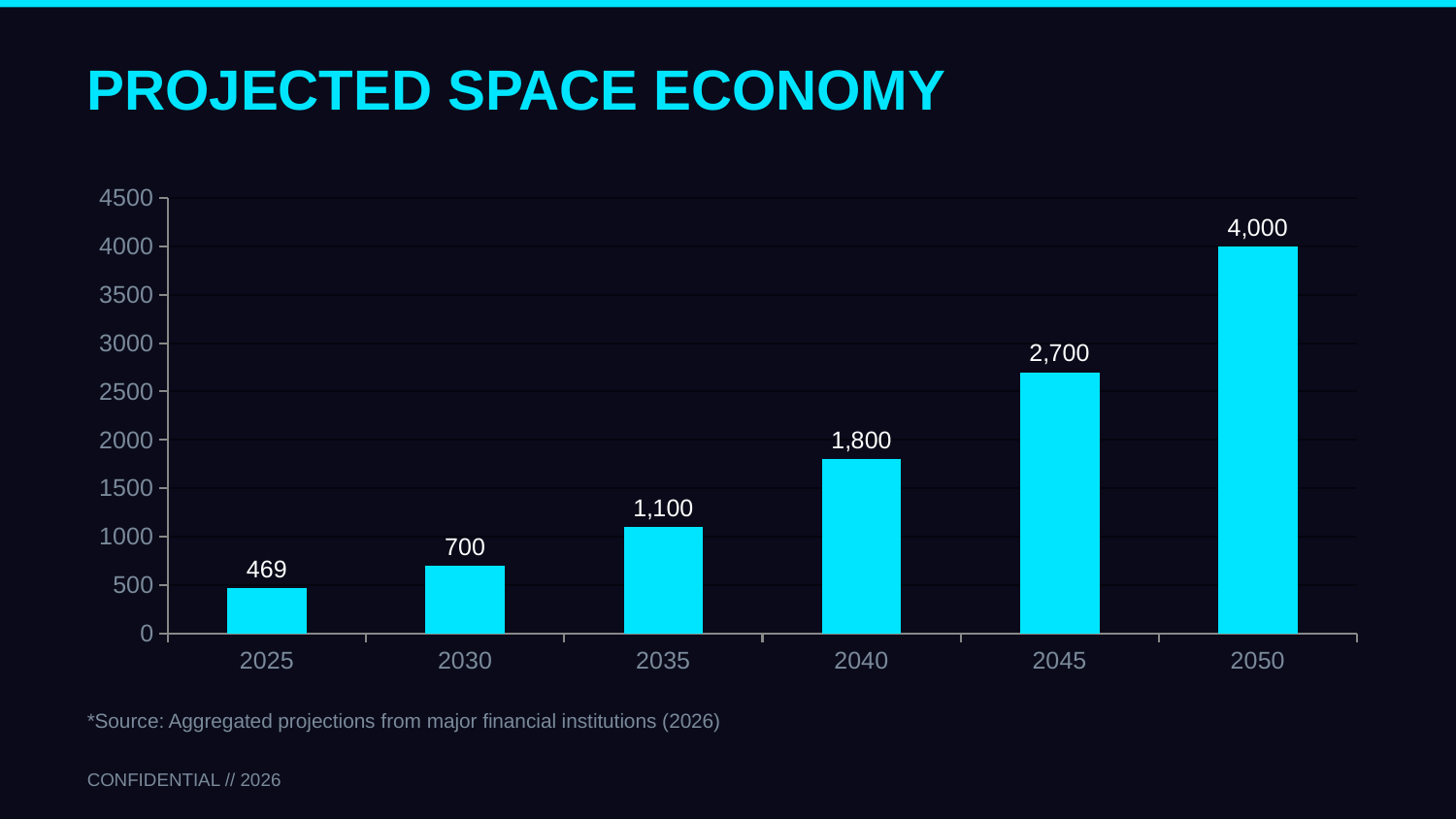
Do the values rise or fall from 2025 to 2050? Rise What is the projected value for 2025? 469 What is the difference between the values for 2050 and 2040? 2,200 What kind of chart is shown on the slide? Bar chart Which is larger, the value for 2040 or the value for 2035? 2040 Is the value for 2045 greater or less than 2500? greater Which year has the highest projected value? 2050 How many years are shown on the x axis? 6 Which year has the lowest projected value? 2025 What is the projected value for 2045? 2,700 What is the difference between the values for 2030 and 2025? 231 What is the projected value for 2035? 1,100